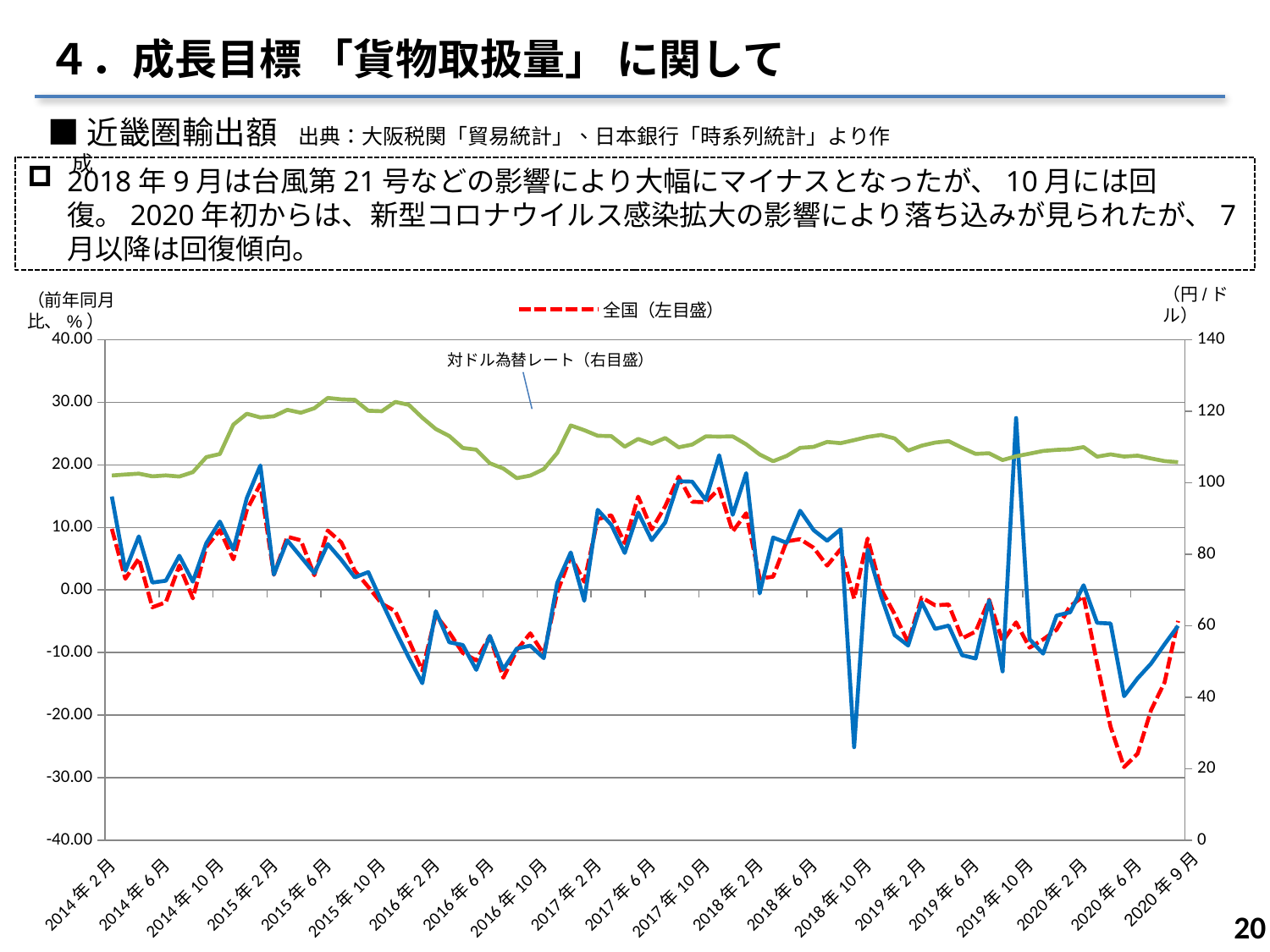
Is the value of 全国（左目盛） at 2020年6月 greater or less than -20.00? less What is the legend entry shown above the chart? 全国（左目盛） What kind of chart is shown on the slide? line chart How many series does the chart's legend list? 1 How many date labels are shown along the x axis? 21 Does 全国（左目盛） rise or fall from 2020年2月 to 2020年6月? fall Is the value of 対ドル為替レート（右目盛） at 2015年6月 greater or less than 120? greater Which series is plotted against the right axis according to the annotation on the chart? 対ドル為替レート（右目盛）